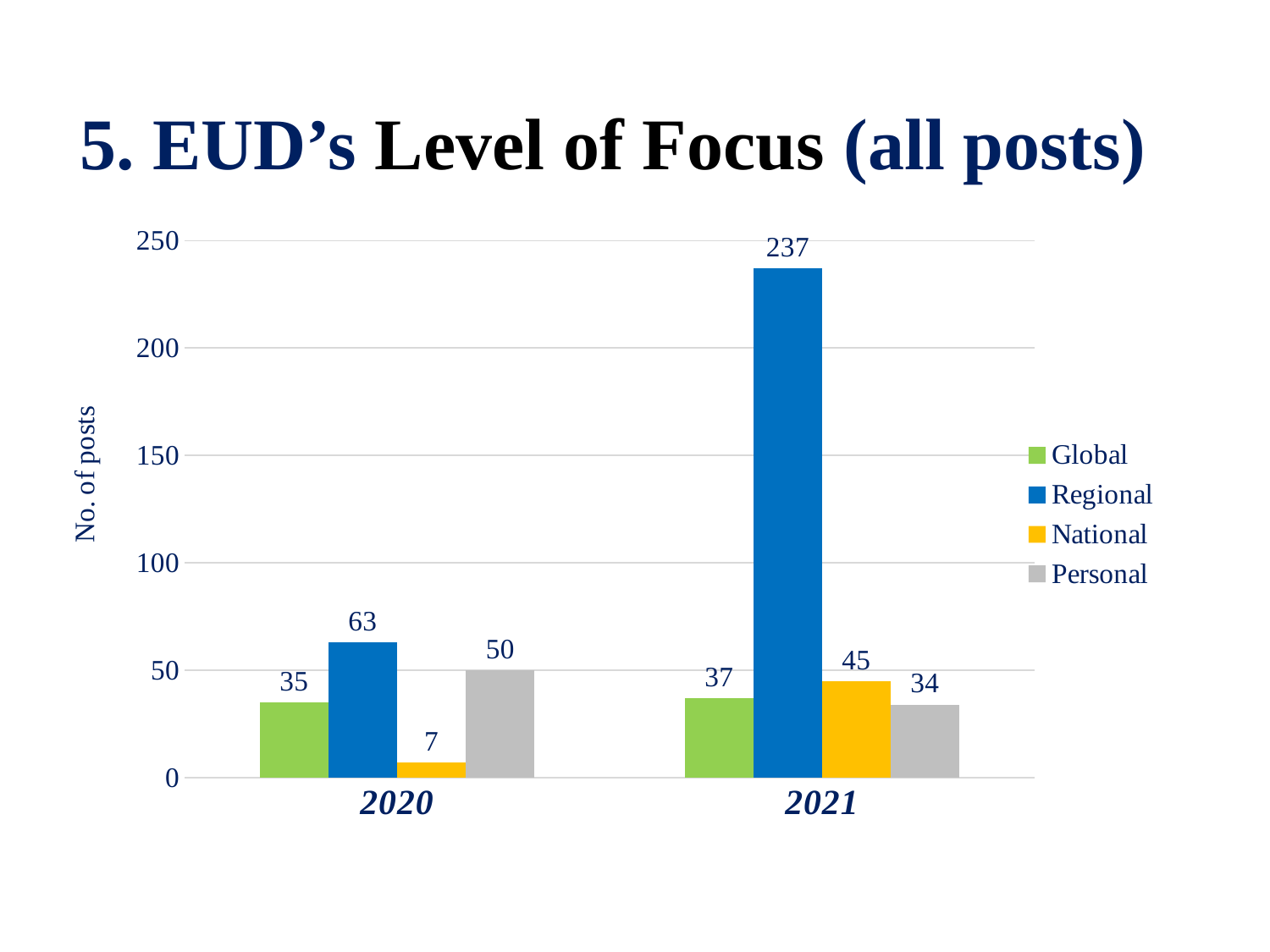
What is the difference between Regional posts in 2021 and Regional posts in 2020? 174 Which series has the highest value in 2021? Regional What is the number of National posts in 2020? 7 How many years are shown on the x axis? 2 How many series does the legend list? 4 What is the number of Personal posts in 2021? 34 Is the value for Regional posts in 2021 greater or less than 200? greater What is the label of the vertical axis? No. of posts Which series has the lowest value in 2020? National Which is larger, Personal posts in 2020 or Personal posts in 2021? Personal posts in 2020 What is the number of Regional posts in 2021? 237 What kind of chart is shown on the slide? bar chart